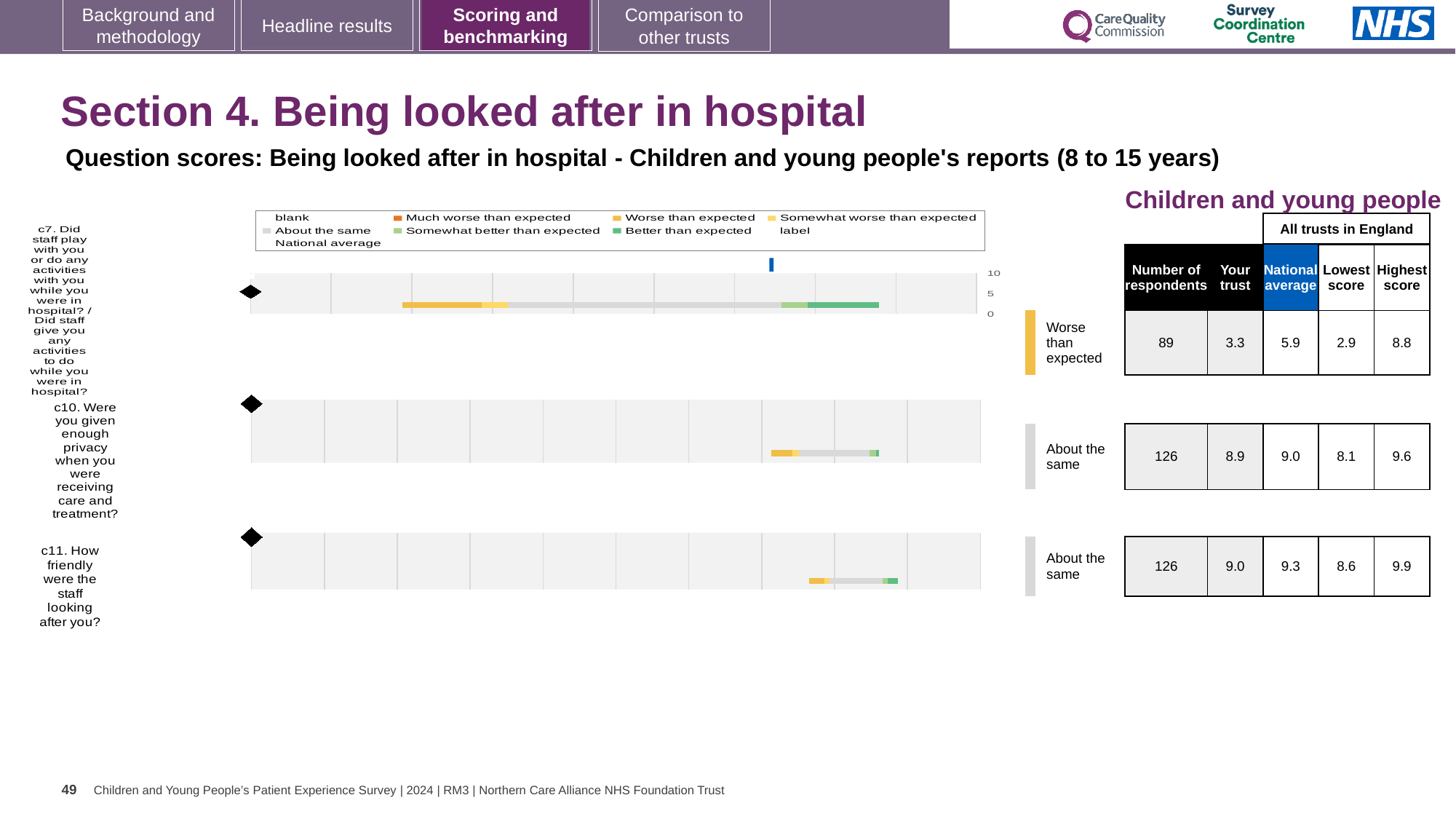
What kind of chart is used to show the question scores on this slide? bar chart How many respondents are listed for question c11 (How friendly were the staff looking after you?)? 126 What is the 'Your trust' score for question c7 (Did staff play with you or do any activities with you while you were in hospital?)? 3.3 What is the difference between the highest score and the lowest score for question c11? 1.3 What is the national average score for question c10 (Were you given enough privacy when you were receiving care and treatment?)? 9.0 For question c7, how much higher is the national average than the 'Your trust' score? 2.6 For question c7, which is larger: the 'Your trust' score or the national average? National average Which question has the lowest 'Your trust' score? c7. Did staff play with you or do any activities with you while you were in hospital? How many questions are plotted in the chart on this slide? 3 What is the highest score across all trusts in England for question c7? 8.8 What benchmark category label is shown next to the bar for question c7? Worse than expected Which question has the highest 'Your trust' score? c11. How friendly were the staff looking after you?